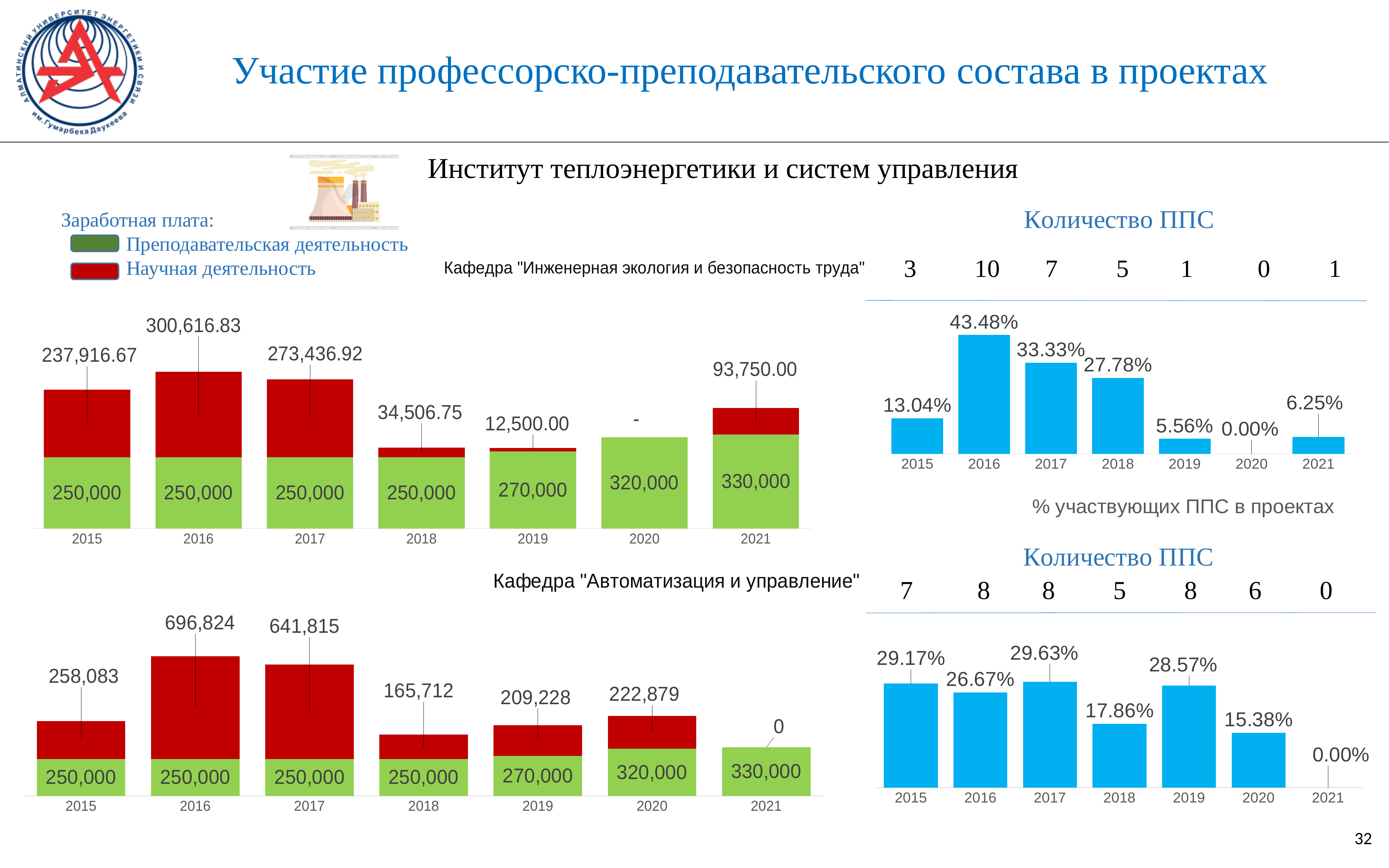
In the bottom-left stacked bar chart for the department "Автоматизация и управление", what is the value of the red (Научная деятельность) segment for 2017? 641,815 In the top-left stacked bar chart for the department "Инженерная экология и безопасность труда", what is the value of the red (Научная деятельность) segment for 2016? 300,616.83 In the bottom-left stacked bar chart for the department "Автоматизация и управление", what is the total of the stacked bar for 2016? 946,824 In the top-right bar chart "% участвующих ППС в проектах" for the department "Инженерная экология и безопасность труда", what is the value for 2017? 33.33% In the top-left stacked bar chart for the department "Инженерная экология и безопасность труда", which year has the highest red (Научная деятельность) value? 2016 In the top-right bar chart "% участвующих ППС в проектах" for the department "Инженерная экология и безопасность труда", which year has the lowest value? 2020 In the top-right bar chart "% участвующих ППС в проектах" for the department "Инженерная экология и безопасность труда", which year has the highest value? 2016 In the bottom-left stacked bar chart for the department "Автоматизация и управление", what is the difference between the red (Научная деятельность) values for 2016 and 2017? 55,009 In the top-left stacked bar chart for the department "Инженерная экология и безопасность труда", what is the value of the green (Преподавательская деятельность) segment for 2020? 320,000 How many years (categories) are shown on the x axis of the top-left stacked bar chart? 7 In the bottom-right bar chart for the department "Автоматизация и управление", what is the value for 2019? 28.57% In the bottom-right bar chart for the department "Автоматизация и управление", which is larger, the value for 2018 or the value for 2020? 2018